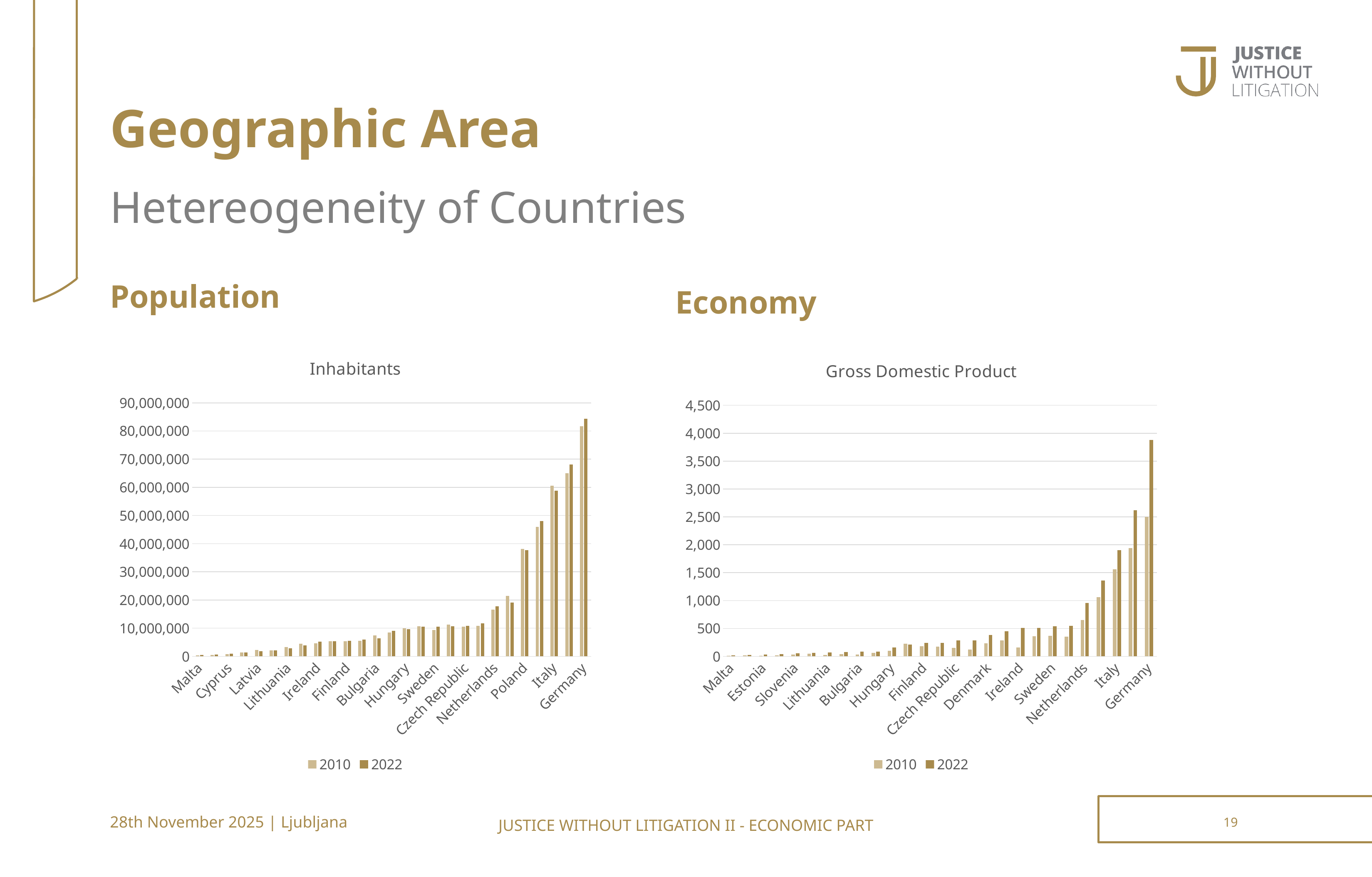
How many series does the legend of the Gross Domestic Product chart list? 2 In the Gross Domestic Product chart, which is larger in 2022: Germany or Italy? Germany What kind of chart is the Inhabitants chart on the left? bar chart In the Gross Domestic Product chart, is the 2010 value for Germany greater or less than 3,000? less In the Gross Domestic Product chart, which country has the lowest GDP? Malta In the Inhabitants chart, is the 2022 value for Poland greater or less than 40,000,000? less In the Inhabitants chart, do the values generally rise or fall from left to right along the x axis? rise In the Inhabitants chart, which country has the highest number of inhabitants? Germany In the Gross Domestic Product chart, is the 2022 value for Germany greater or less than 3,500? greater What are the two years listed in the legend of the Inhabitants chart? 2010 and 2022